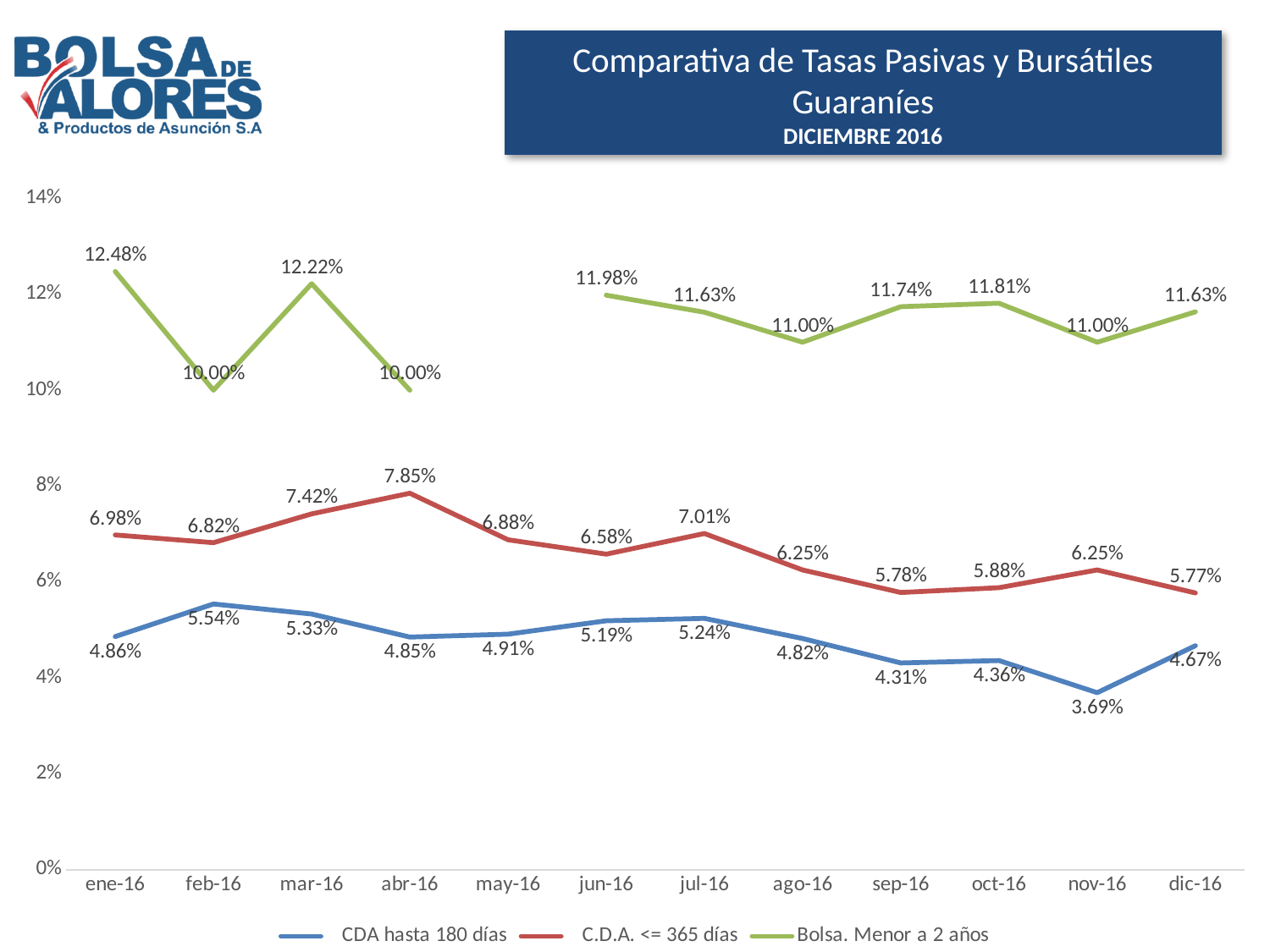
What is the value of the 'Bolsa. Menor a 2 años' series in ene-16? 12.48% What kind of chart is shown on the slide? line chart How many series does the legend list? 3 Which is larger in jul-16: the 'C.D.A. <= 365 días' value or the 'CDA hasta 180 días' value? C.D.A. <= 365 días What colour is the line for the 'Bolsa. Menor a 2 años' series? green How many months are shown on the x axis? 12 What is the value of the 'C.D.A. <= 365 días' series in abr-16? 7.85% In which month does the 'CDA hasta 180 días' series reach its highest value? feb-16 In which month does the 'C.D.A. <= 365 días' series reach its lowest value? dic-16 Is the 'Bolsa. Menor a 2 años' value in ago-16 greater or less than 12%? less What is the difference between the 'C.D.A. <= 365 días' value and the 'CDA hasta 180 días' value in dic-16? 1.10% What is the value of the 'CDA hasta 180 días' series in nov-16? 3.69%